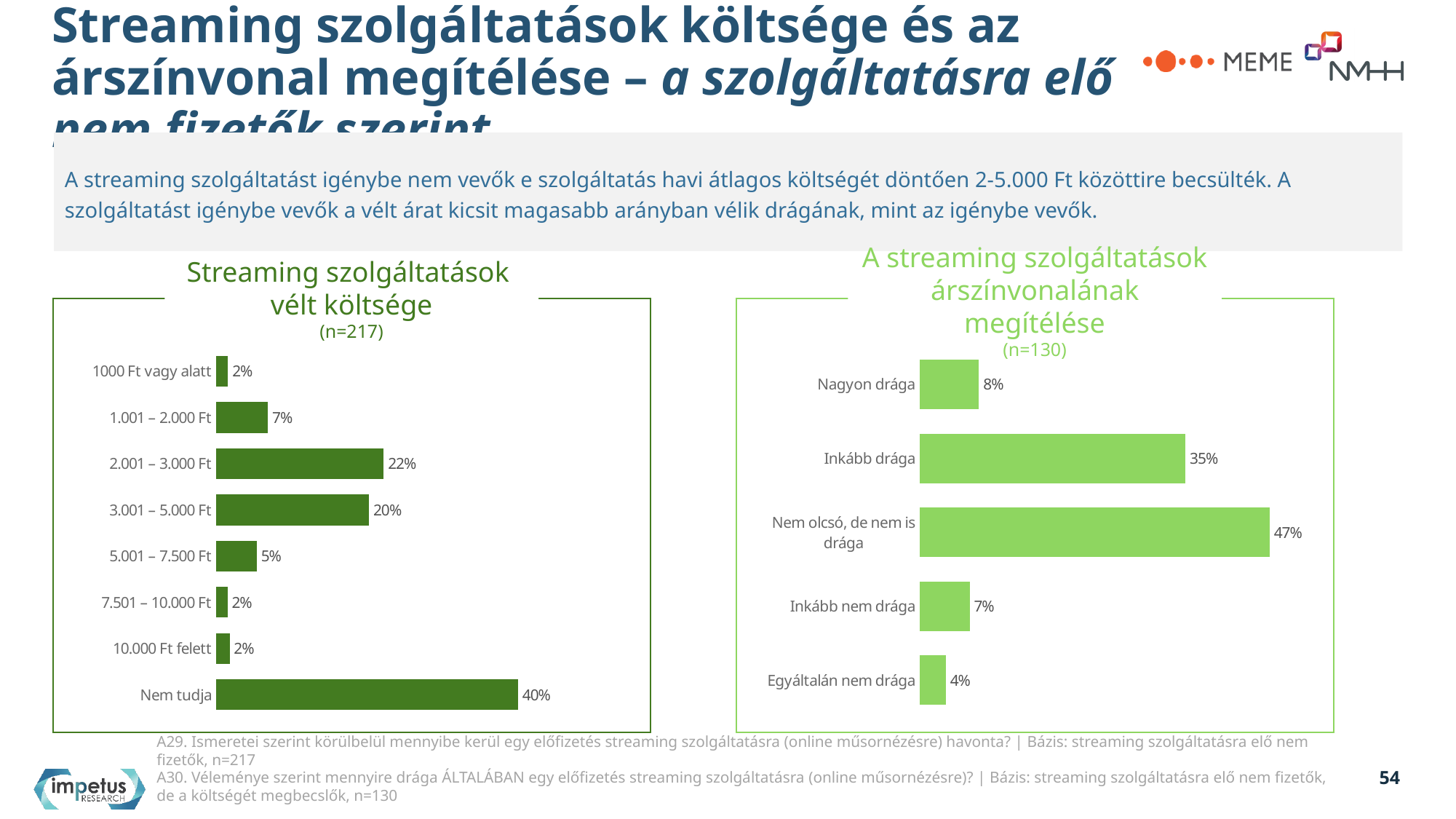
In the chart 'Streaming szolgáltatások vélt költsége', what is the value for '5.001 – 7.500 Ft'? 5% In the chart 'Streaming szolgáltatások vélt költsége', what is the value for '2.001 – 3.000 Ft'? 22% In the chart 'Streaming szolgáltatások vélt költsége', which category has the highest value? Nem tudja In the chart 'Streaming szolgáltatások vélt költsége', what is the difference between '2.001 – 3.000 Ft' and '3.001 – 5.000 Ft'? 2 percentage points In the chart 'A streaming szolgáltatások árszínvonalának megítélése', what is the value for 'Nem olcsó, de nem is drága'? 47% In the chart 'A streaming szolgáltatások árszínvonalának megítélése', which is larger: 'Nagyon drága' or 'Inkább nem drága'? Nagyon drága What type of chart is 'A streaming szolgáltatások árszínvonalának megítélése'? Bar chart What is the sample size (n) shown under the title of the chart 'Streaming szolgáltatások vélt költsége'? n=217 In the chart 'A streaming szolgáltatások árszínvonalának megítélése', what is the difference between 'Nem olcsó, de nem is drága' and 'Inkább drága'? 12 percentage points In the chart 'Streaming szolgáltatások vélt költsége', how many categories are shown? 8 In the chart 'A streaming szolgáltatások árszínvonalának megítélése', which category has the lowest value? Egyáltalán nem drága In the chart 'A streaming szolgáltatások árszínvonalának megítélése', how many categories are shown? 5